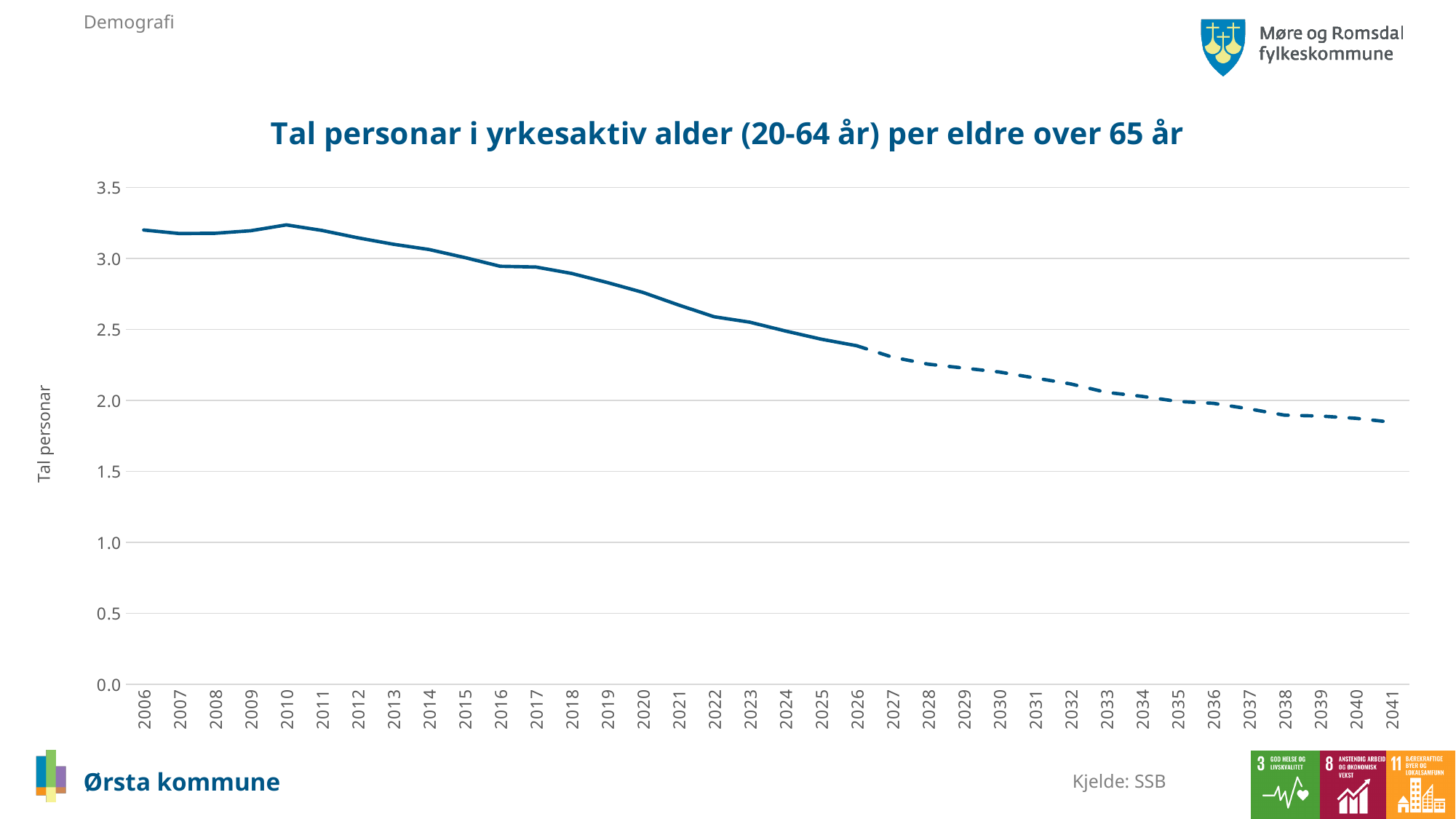
What kind of chart is shown on the slide? line chart Is the value for 2041 greater or less than 2.0? less Which year has the larger value, 2006 or 2041? 2006 Is the value for 2030 greater or less than 2.5? less What is the title of the chart? Tal personar i yrkesaktiv alder (20-64 år) per eldre over 65 år How many years are shown along the x axis of the chart? 36 Do the values rise or fall along the x axis from 2010 to 2041? fall Is the value for 2006 greater or less than 3.0? greater Which year has the larger value, 2015 or 2025? 2015 What is the label on the vertical axis of the chart? Tal personar Which year has the lowest value on the chart? 2041